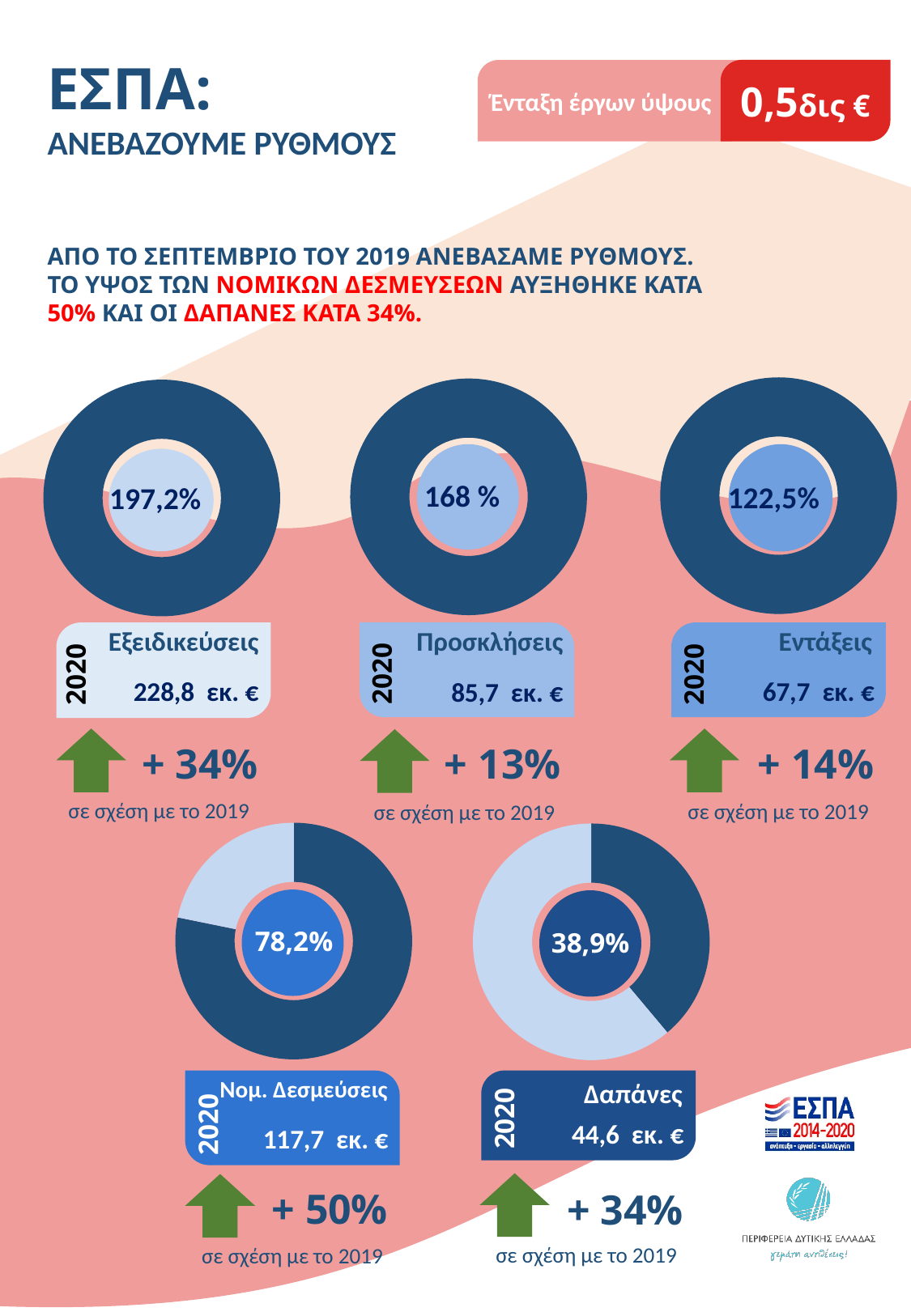
What percentage increase compared to 2019 is shown below the Νομ. Δεσμεύσεις donut chart? + 50% How many donut charts are shown on the slide? 5 What percentage is shown in the centre of the Εντάξεις donut chart? 122,5% Which of the five donut charts shows the lowest percentage? Δαπάνες What percentage is shown in the centre of the Δαπάνες donut chart? 38,9% Is the percentage in the Νομ. Δεσμεύσεις donut chart larger or smaller than the percentage in the Δαπάνες donut chart? larger What percentage is shown in the centre of the Νομ. Δεσμεύσεις donut chart? 78,2% What percentage is shown in the centre of the Προσκλήσεις donut chart? 168 % Which of the five donut charts shows the highest percentage? Εξειδικεύσεις What is the 2020 value shown below the Νομ. Δεσμεύσεις donut chart? 117,7 εκ. € What percentage is shown in the centre of the Εξειδικεύσεις donut chart? 197,2% What is the 2020 value shown below the Δαπάνες donut chart? 44,6 εκ. €